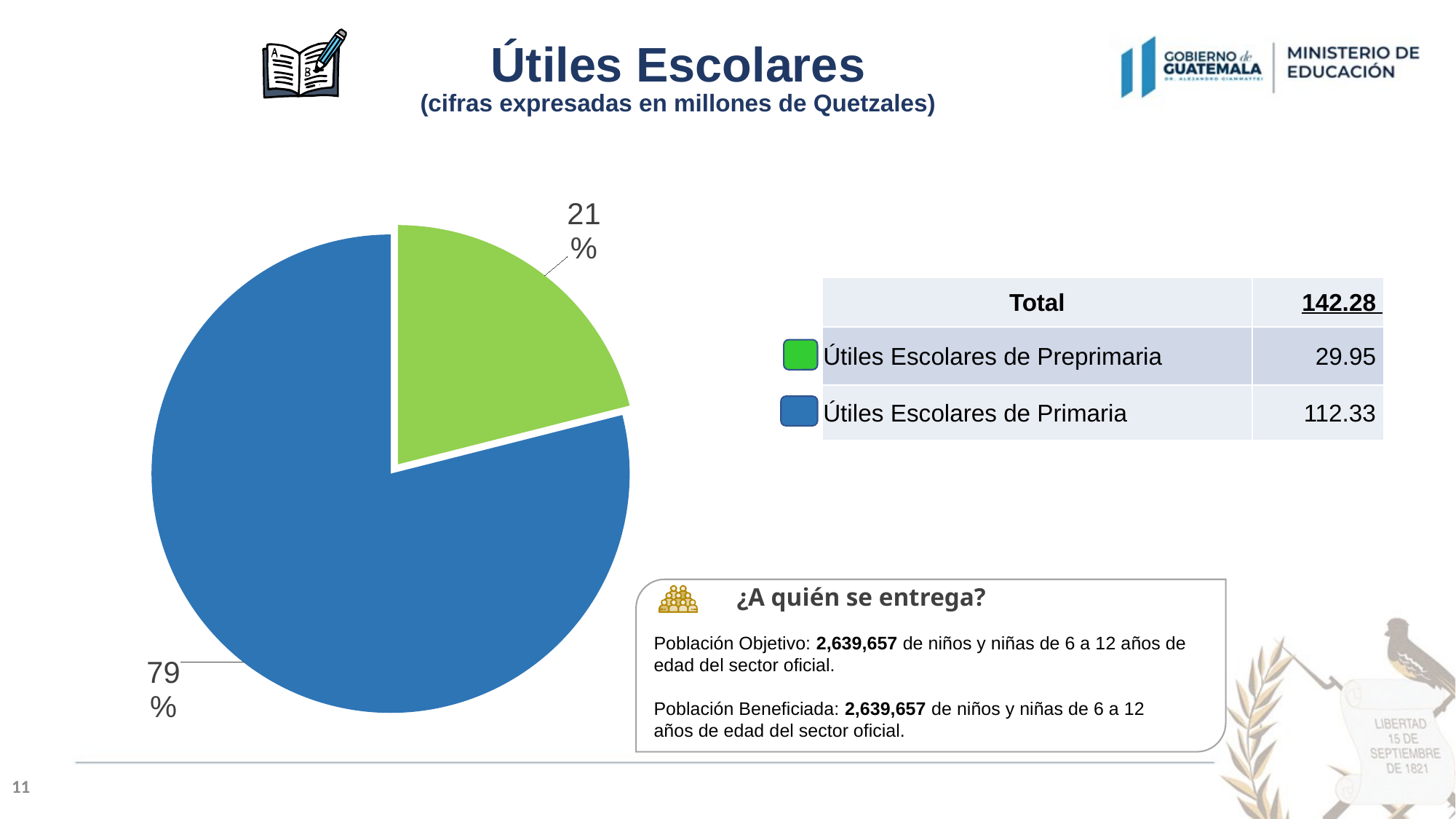
Which is larger, the slice for Útiles Escolares de Preprimaria or the slice for Útiles Escolares de Primaria? Útiles Escolares de Primaria What share of the pie does Útiles Escolares de Preprimaria represent? 21% Which category has the largest slice of the pie? Útiles Escolares de Primaria What is the difference between the values for Útiles Escolares de Primaria and Útiles Escolares de Preprimaria, in millions of Quetzales? 82.38 What colour is the slice for Útiles Escolares de Preprimaria? green What share of the pie does Útiles Escolares de Primaria represent? 79% Which category has the smallest slice of the pie? Útiles Escolares de Preprimaria What is the value for Útiles Escolares de Preprimaria in millions of Quetzales? 29.95 What is the value for Útiles Escolares de Primaria in millions of Quetzales? 112.33 What is the total of the two categories shown in the chart, in millions of Quetzales? 142.28 What kind of chart is shown on the slide? pie chart How many slices does the pie chart have? 2